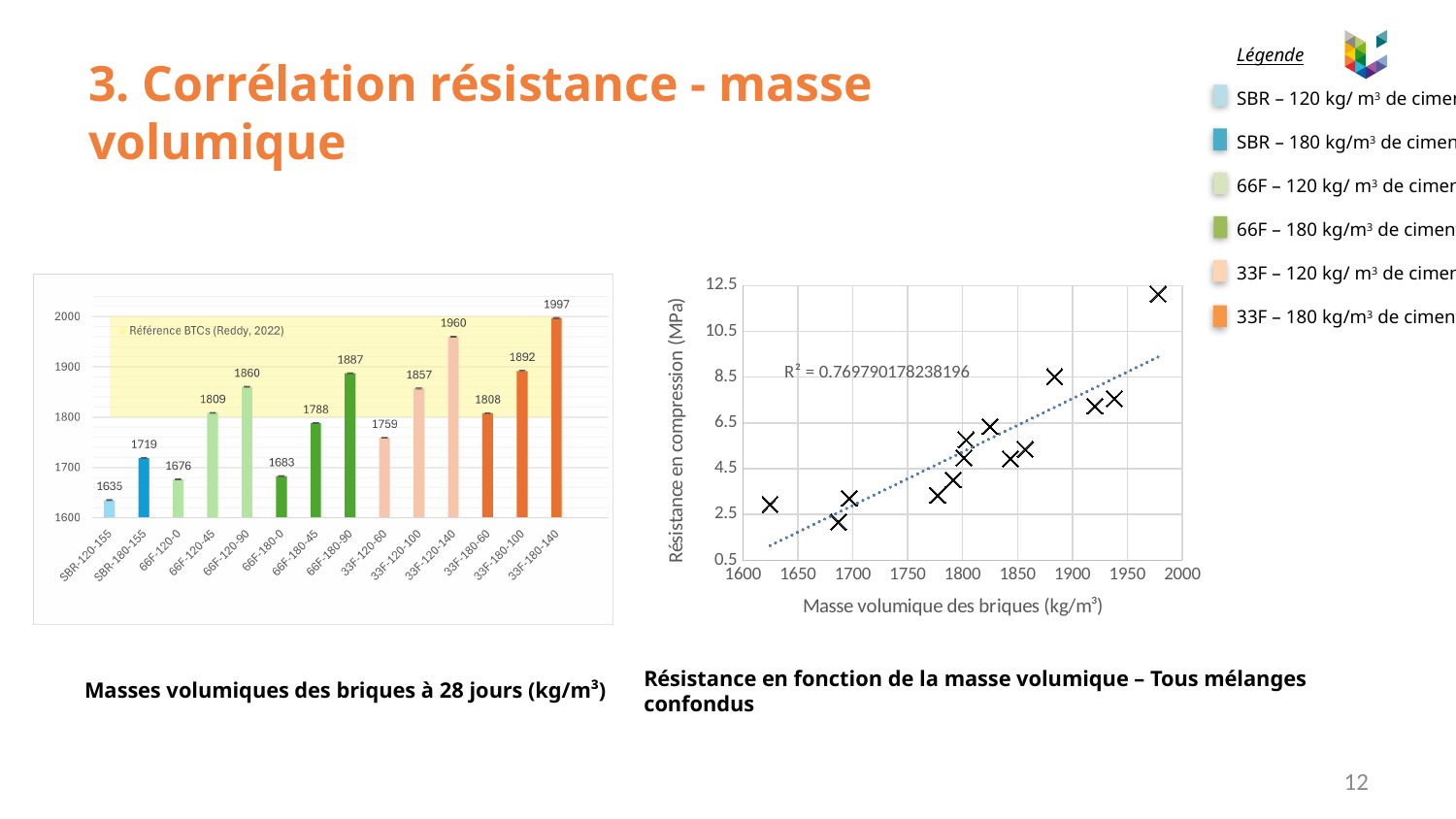
What kind of chart is the right chart 'Résistance en fonction de la masse volumique – Tous mélanges confondus'? scatter chart How many categories are shown in the bar chart 'Masses volumiques des briques à 28 jours (kg/m³)'? 14 In the bar chart 'Masses volumiques des briques à 28 jours (kg/m³)', what is the difference between the values for 33F-180-140 and SBR-120-155? 362 In the bar chart 'Masses volumiques des briques à 28 jours (kg/m³)', what is the value for 33F-120-140? 1960 In the bar chart 'Masses volumiques des briques à 28 jours (kg/m³)', which is larger: the value for 66F-120-90 or the value for 33F-120-100? 66F-120-90 In the scatter chart 'Résistance en fonction de la masse volumique – Tous mélanges confondus', what R² value is displayed? R² = 0.769790178238196 In the scatter chart 'Résistance en fonction de la masse volumique – Tous mélanges confondus', do the compressive strength values generally rise or fall as the density increases along the x axis? rise What kind of chart is the left chart 'Masses volumiques des briques à 28 jours (kg/m³)'? bar chart In the bar chart 'Masses volumiques des briques à 28 jours (kg/m³)', what is the value for 66F-180-45? 1788 In the scatter chart 'Résistance en fonction de la masse volumique – Tous mélanges confondus', is the compressive strength of the point with the highest density greater or less than 10.5 MPa? greater In the bar chart 'Masses volumiques des briques à 28 jours (kg/m³)', which category has the lowest value? SBR-120-155 In the bar chart 'Masses volumiques des briques à 28 jours (kg/m³)', which category has the highest value? 33F-180-140